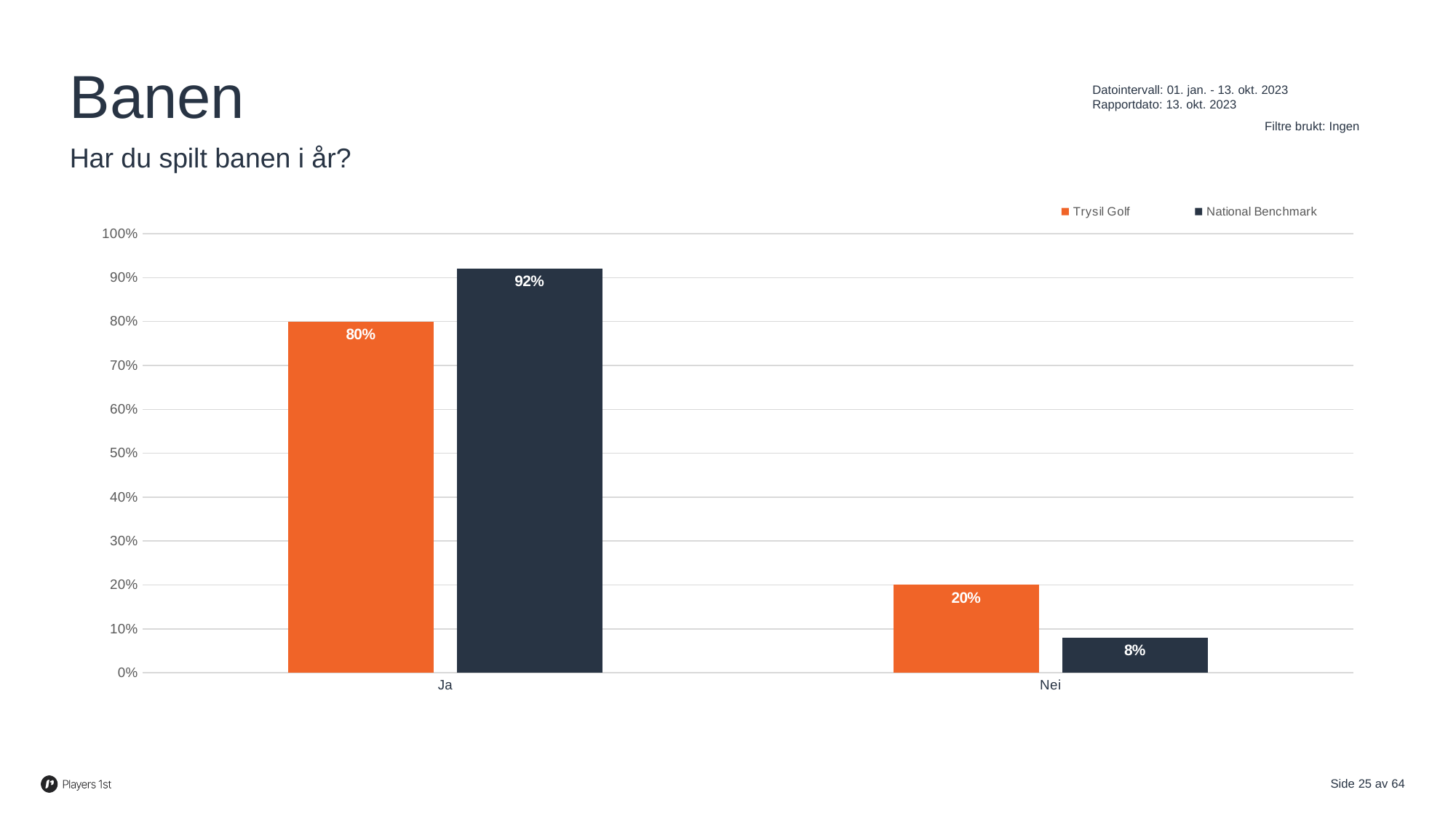
What colour are the Trysil Golf bars? Orange Which series has the higher value in the Ja category? National Benchmark What is the value for Trysil Golf in the Nei category? 20% What is the difference between Trysil Golf and National Benchmark in the Nei category? 12% What kind of chart is shown on the slide? Bar chart What is the value for National Benchmark in the Ja category? 92% How many series does the legend list? 2 What is the value for National Benchmark in the Nei category? 8% Which series has the higher value in the Nei category? Trysil Golf What is the difference between National Benchmark and Trysil Golf in the Ja category? 12% What is the value for Trysil Golf in the Ja category? 80% How many categories are shown on the x axis? 2